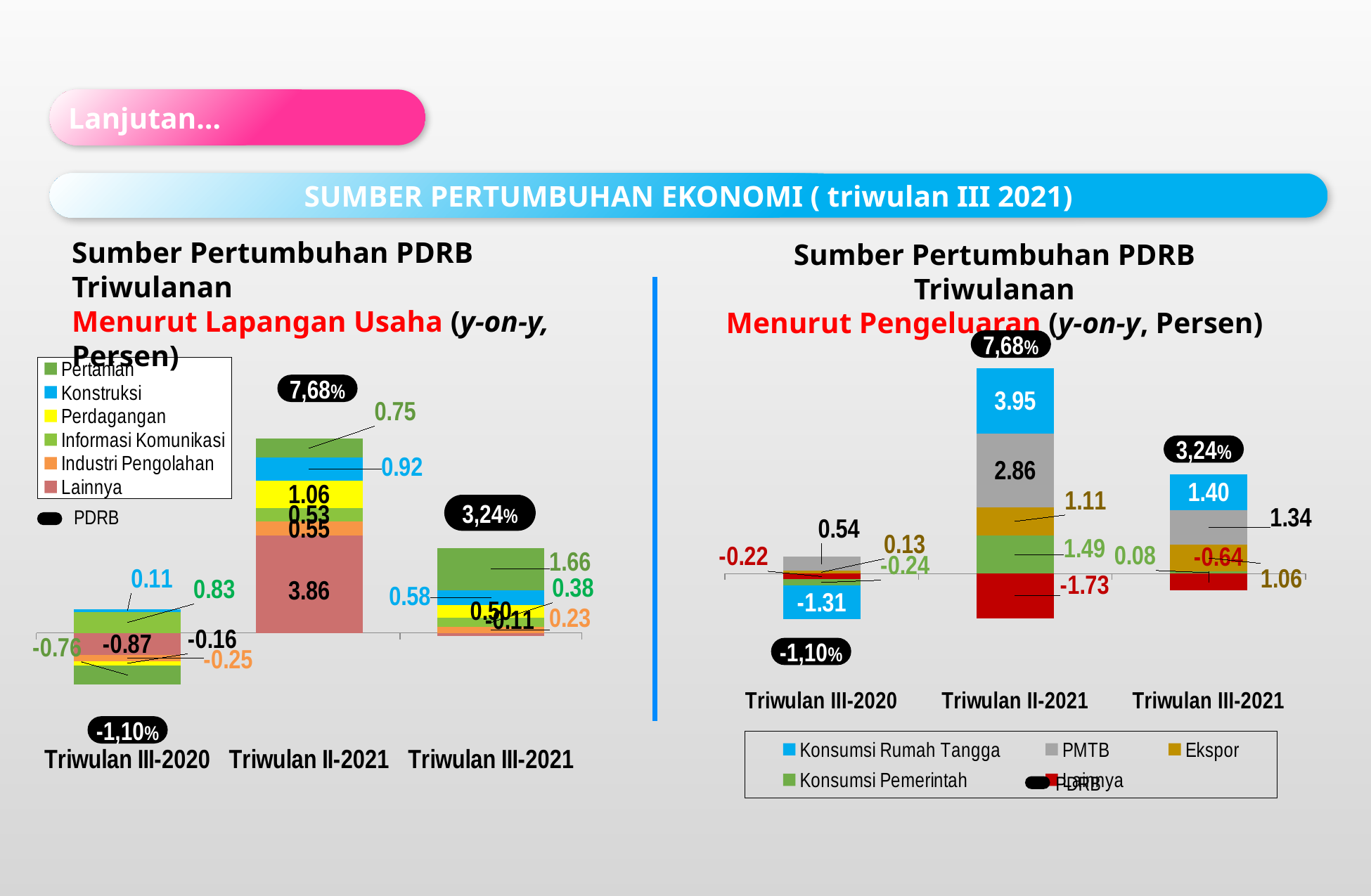
In the left chart (Menurut Lapangan Usaha), how many series does the legend list (excluding PDRB)? 6 In the left chart (Menurut Lapangan Usaha), what is the value for Perdagangan in Triwulan II-2021? 1.06 In the left chart (Menurut Lapangan Usaha), what is the PDRB growth shown for Triwulan III-2021? 3,24% In the right chart (Menurut Pengeluaran), what is the value for PMTB in Triwulan II-2021? 2.86 In the right chart (Menurut Pengeluaran), which is larger in Triwulan II-2021: Konsumsi Rumah Tangga or Konsumsi Pemerintah? Konsumsi Rumah Tangga What type of chart is used on the right side of the slide (Menurut Pengeluaran)? Stacked bar chart In the left chart (Menurut Lapangan Usaha), what is the PDRB growth shown for Triwulan III-2020? -1,10% In the right chart (Menurut Pengeluaran), what is the value for Konsumsi Rumah Tangga in Triwulan II-2021? 3.95 In the right chart (Menurut Pengeluaran), what is the value for Konsumsi Rumah Tangga in Triwulan III-2020? -1.31 In the right chart (Menurut Pengeluaran), what is the difference between Konsumsi Rumah Tangga in Triwulan II-2021 (3.95) and PMTB in Triwulan II-2021 (2.86)? 1.09 In the left chart (Menurut Lapangan Usaha), what is the value for Lainnya in Triwulan II-2021? 3.86 In the left chart (Menurut Lapangan Usaha), which quarter has the highest PDRB growth? Triwulan II-2021